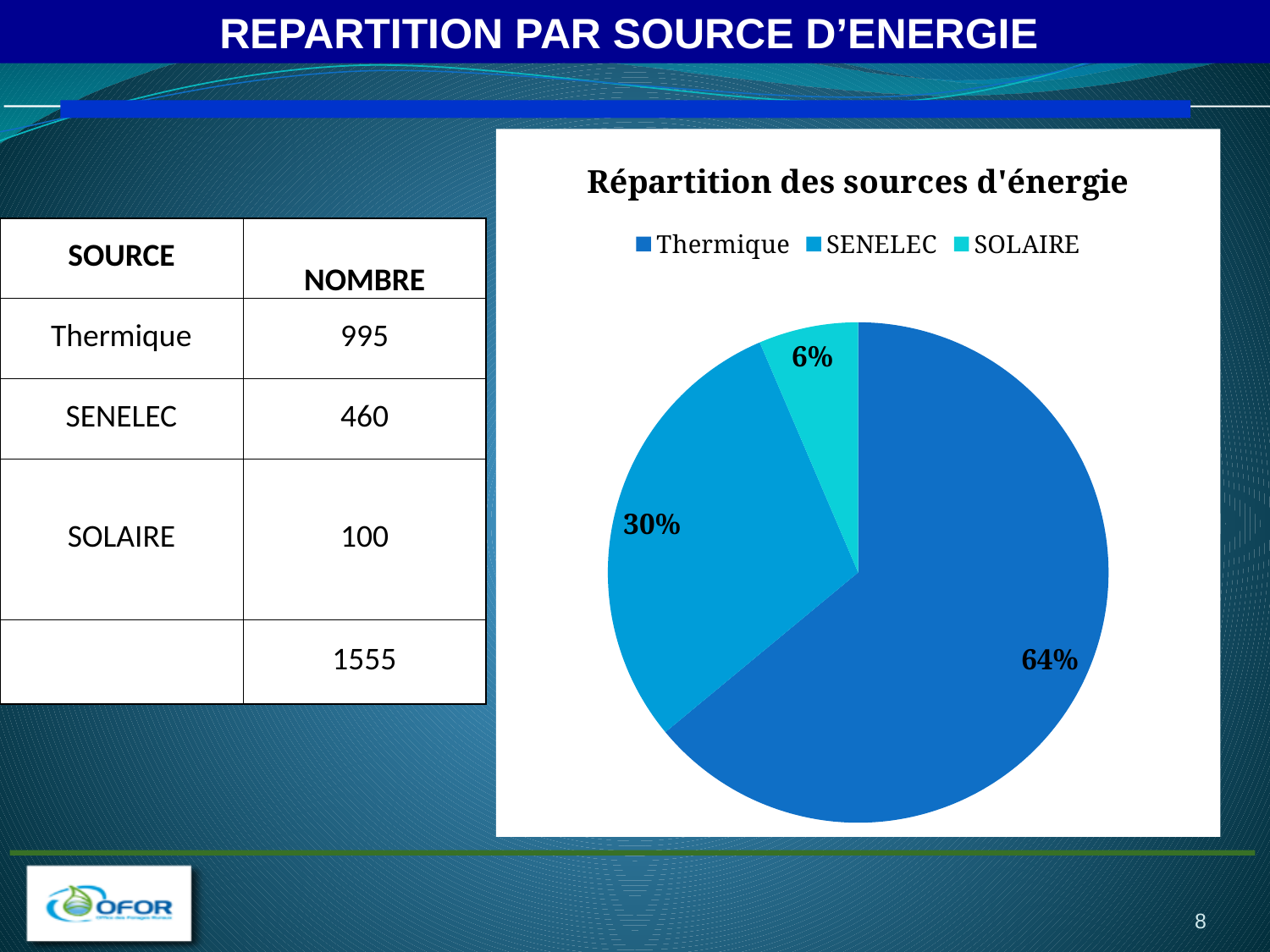
What is the difference in percentage points between the Thermique and SENELEC slices? 34% Which legend entry is shown in the lightest blue colour? SOLAIRE Which source has the largest slice of the pie? Thermique How many entries does the chart legend list? 3 What kind of chart is shown on the slide? pie chart Which source has the smallest slice of the pie? SOLAIRE What is the title of the chart? Répartition des sources d'énergie Which slice is larger, SENELEC or SOLAIRE? SENELEC What share of the pie does Thermique represent? 64% What share of the pie does SOLAIRE represent? 6% What share of the pie does SENELEC represent? 30% How many slices does the pie chart have? 3